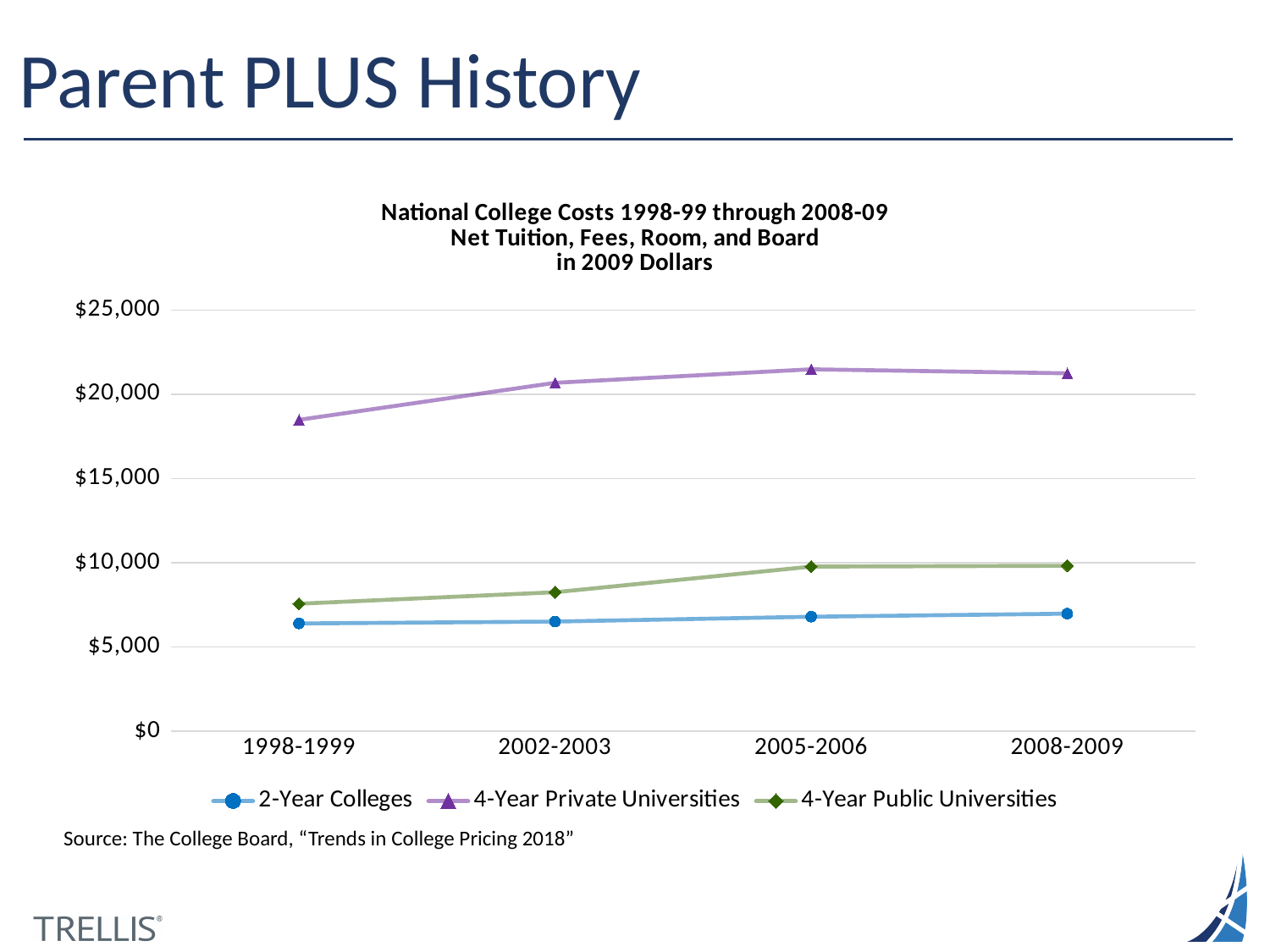
Is the value for 2-Year Colleges in 2008-2009 greater or less than $5,000? greater What kind of chart is shown on the slide? line chart Which series has the highest value in 2008-2009? 4-Year Private Universities Do the values for 2-Year Colleges rise or fall from 1998-1999 to 2008-2009? rise Is the value for 4-Year Private Universities in 2005-2006 greater or less than $20,000? greater Is the value for 4-Year Private Universities in 2008-2009 greater or less than $25,000? less How many series does the legend list? 3 How many academic-year categories are shown on the x axis? 4 Which series has the lowest value in 1998-1999? 2-Year Colleges What source is cited below the chart? The College Board, "Trends in College Pricing 2018" In 2005-2006, which is larger: the value for 4-Year Public Universities or for 2-Year Colleges? 4-Year Public Universities